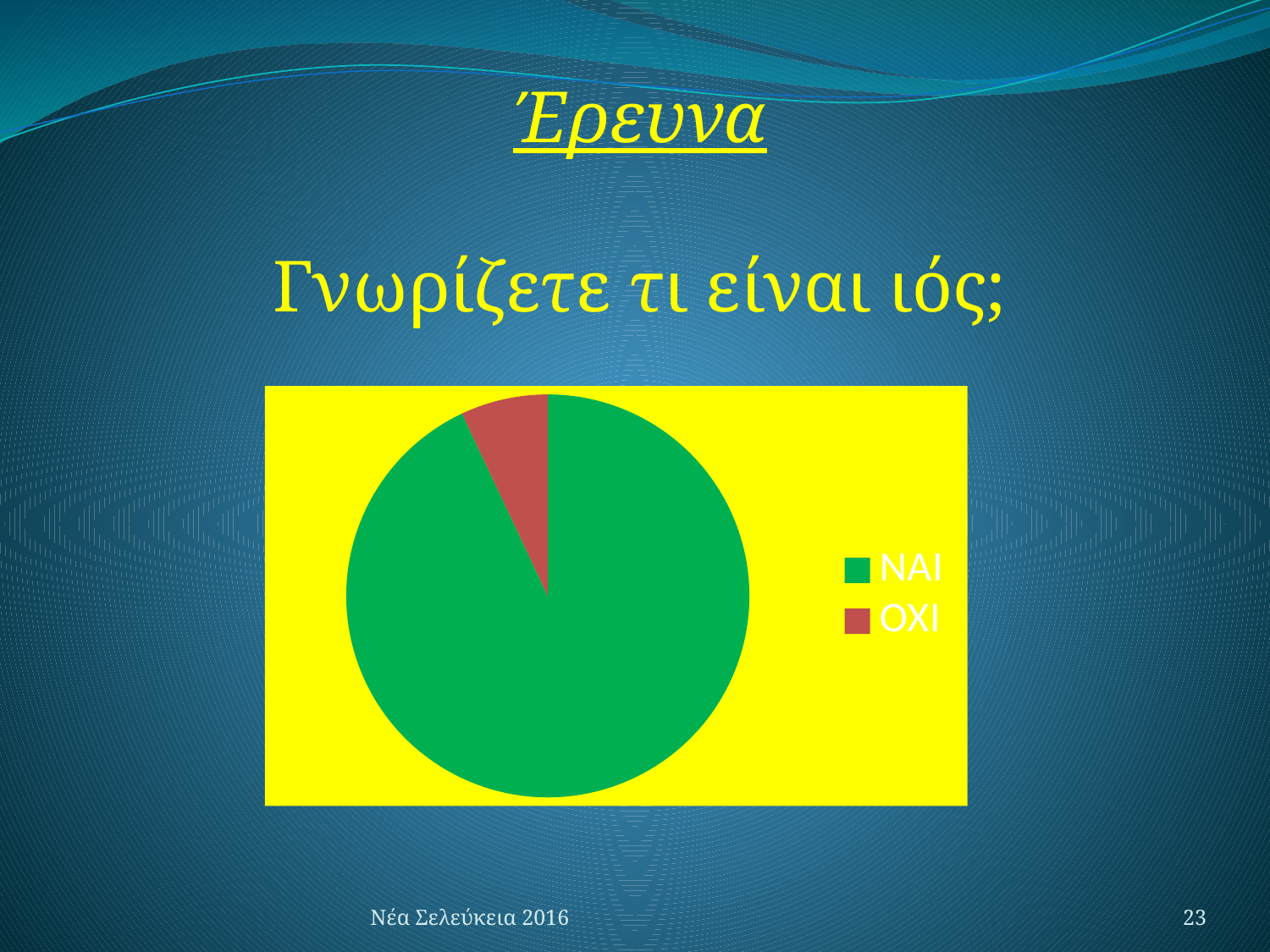
Which category has the largest slice in the pie chart? ΝΑΙ Which slice is larger in the pie chart, ΝΑΙ or ΟΧΙ? ΝΑΙ Does the ΝΑΙ slice take up more or less than half of the pie chart? more What colour is the ΟΧΙ slice in the pie chart? red What kind of chart is shown on the slide? pie chart How many slices does the pie chart have? 2 What colour is the ΝΑΙ slice in the pie chart? green How many entries does the legend of the pie chart list? 2 Which category has the smallest slice in the pie chart? ΟΧΙ